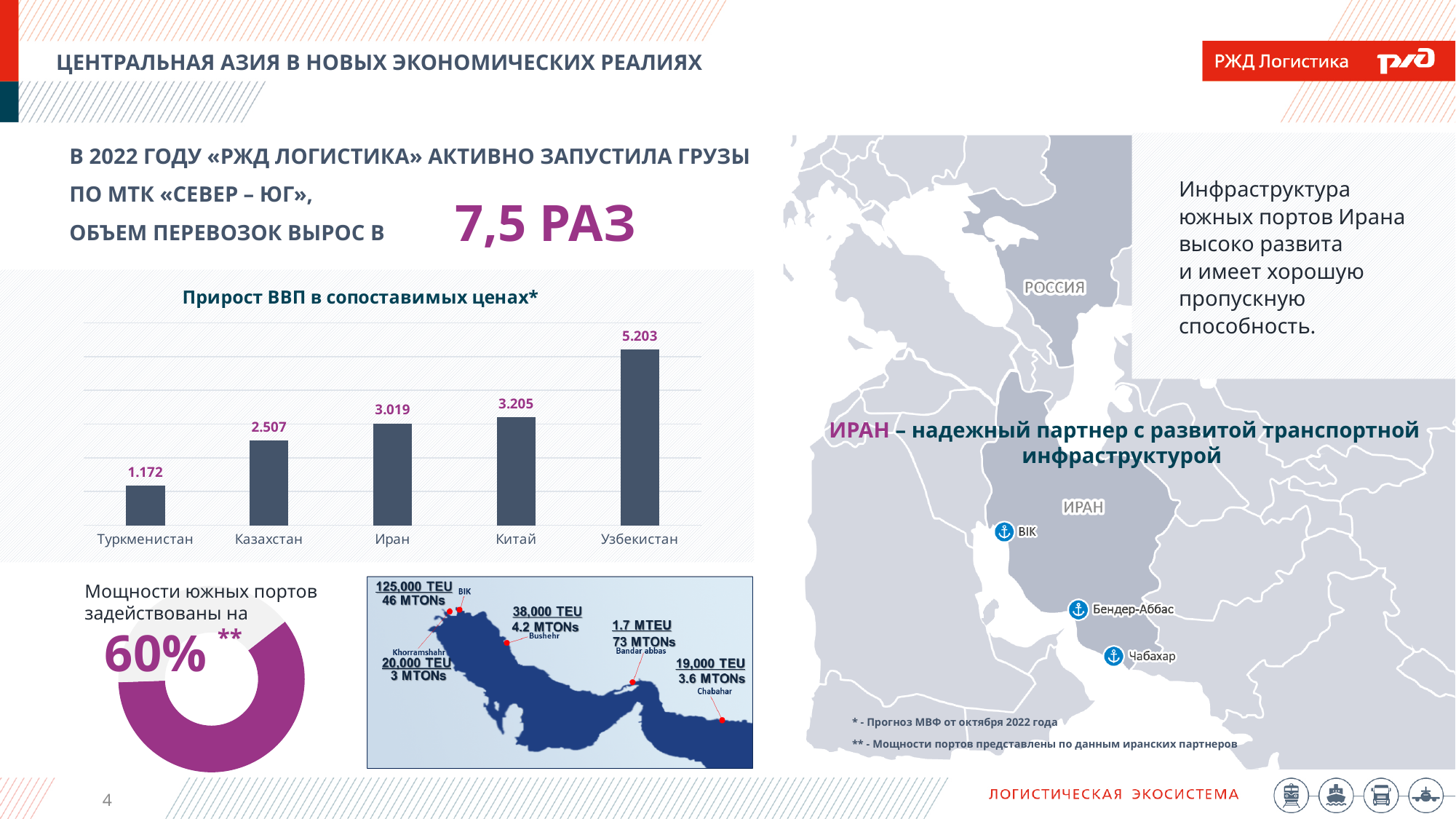
In the bar chart 'Прирост ВВП в сопоставимых ценах*', what is the difference between the values for Узбекистан and Туркменистан? 4.031 In the bar chart 'Прирост ВВП в сопоставимых ценах*', what is the value for Узбекистан? 5.203 In the bar chart 'Прирост ВВП в сопоставимых ценах*', which country has the lowest value? Туркменистан In the bar chart 'Прирост ВВП в сопоставимых ценах*', what is the difference between the values for Китай and Иран? 0.186 In the bar chart 'Прирост ВВП в сопоставимых ценах*', what is the value for Туркменистан? 1.172 In the bar chart 'Прирост ВВП в сопоставимых ценах*', what is the value for Иран? 3.019 In the bar chart 'Прирост ВВП в сопоставимых ценах*', which is larger, the value for Казахстан or the value for Иран? Иран In the bar chart 'Прирост ВВП в сопоставимых ценах*', which country has the highest value? Узбекистан How many countries are shown in the bar chart 'Прирост ВВП в сопоставимых ценах*'? 5 In the donut chart at the bottom left of the slide, what share of southern port capacity is shown as in use? 60% What kind of chart is 'Прирост ВВП в сопоставимых ценах*'? Bar chart What is the title of the bar chart on the left side of the slide? Прирост ВВП в сопоставимых ценах*